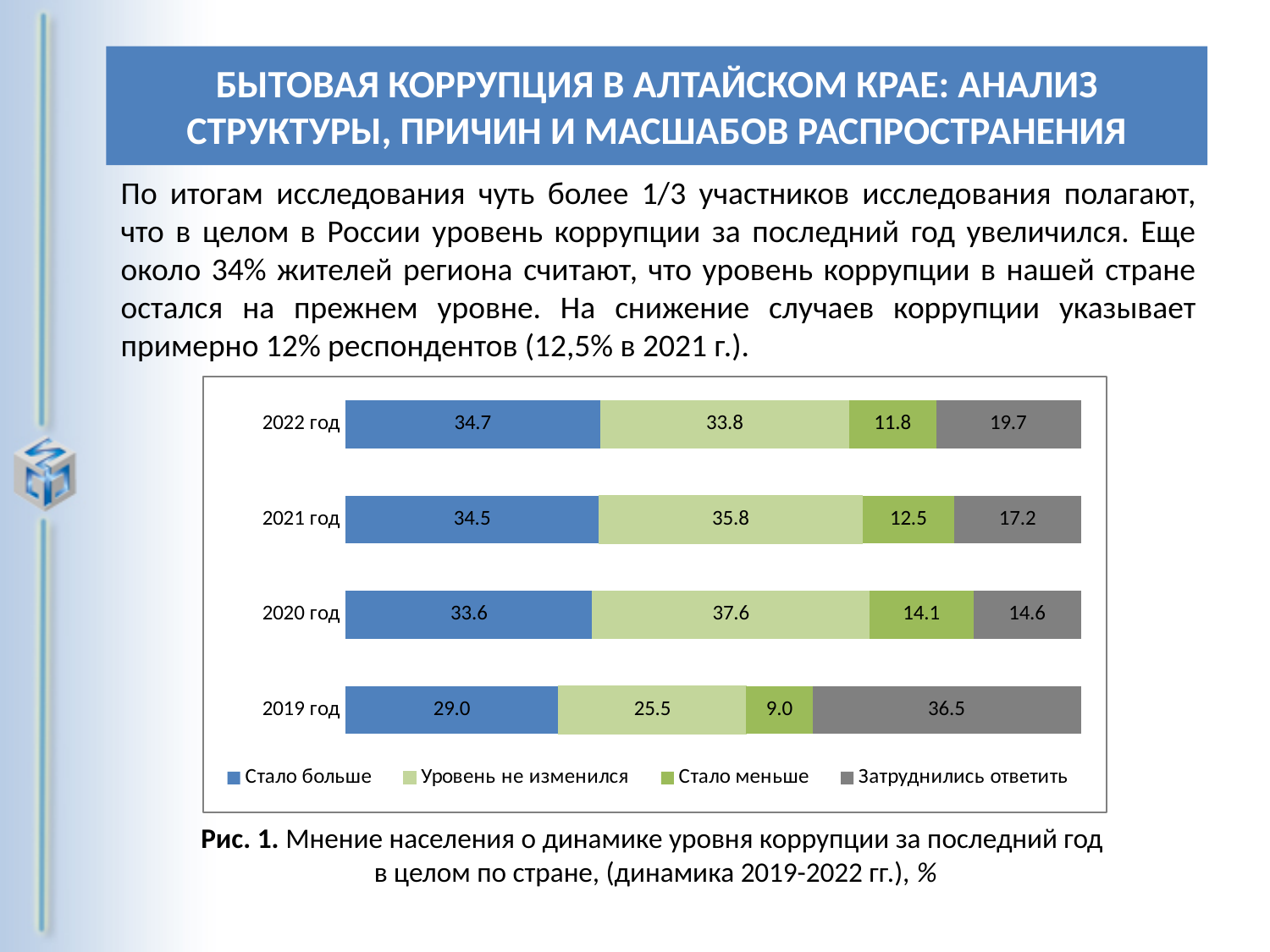
How many years (categories) are plotted in the chart? 4 Which series is shown in dark grey in the chart? Затруднились ответить How many series does the legend list? 4 What is the value for "Стало больше" in 2022 год? 34.7 Which is larger: "Уровень не изменился" in 2021 год or in 2022 год? 2021 год In which year is the value for "Стало больше" the lowest? 2019 год What is the difference between the "Стало меньше" values for 2021 год and 2022 год? 0.7 What is the value for "Затруднились ответить" in 2019 год? 36.5 What type of chart is shown on the slide? Stacked bar chart What is the total of the stacked bar for 2019 год? 100.0 In which year is the value for "Стало меньше" the highest? 2020 год What is the value for "Уровень не изменился" in 2020 год? 37.6